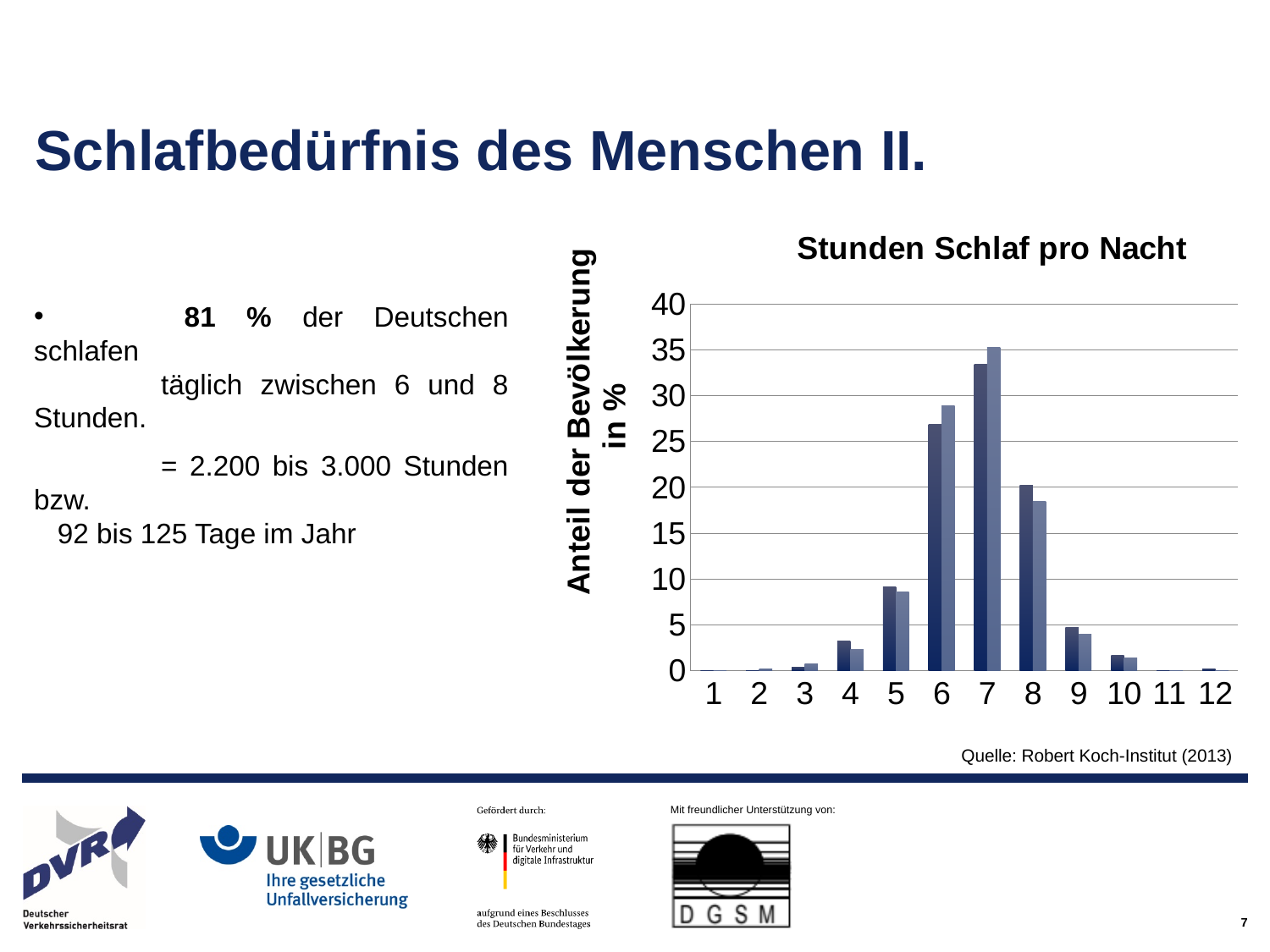
Which category on the x axis has the highest bars? 7 Is the value of the dark blue bar for category 6 greater or less than 25? greater Which has the larger dark blue bar, category 6 or category 8? 6 Do the values rise or fall along the x axis from category 7 to category 12? fall Which has the larger dark blue bar, category 5 or category 9? 5 What is the title of the chart? Stunden Schlaf pro Nacht Is the value of the dark blue bar for category 7 greater or less than 30? greater What type of chart is shown on the slide? bar chart How many categories are shown on the x axis of the chart? 12 Is the value of the dark blue bar for category 5 greater or less than 10? less What is the label of the vertical axis of the chart? Anteil der Bevölkerung in %